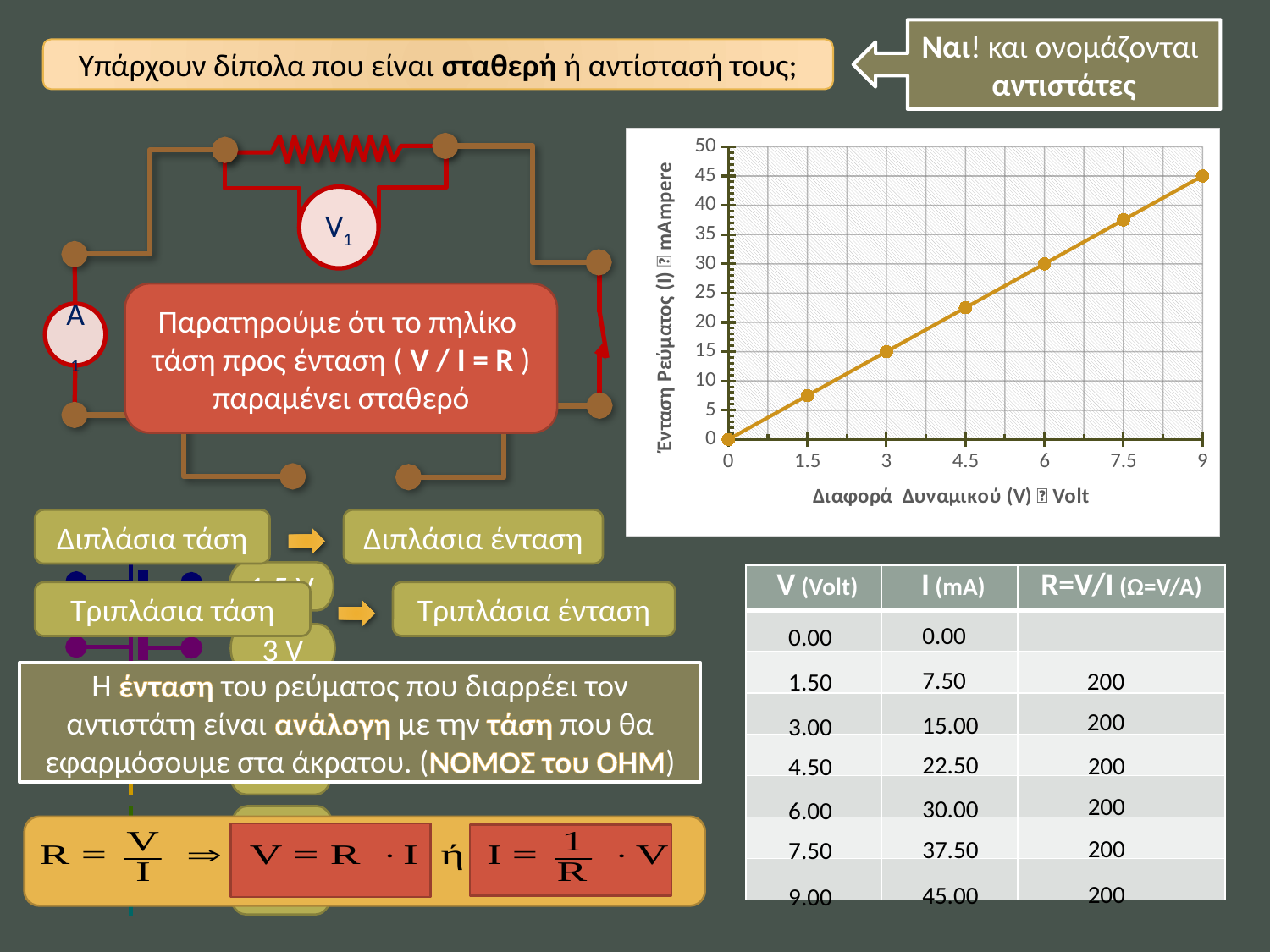
What is the current (I) in mAmpere when the potential difference is 6 Volt? 30 What is the current (I) in mAmpere when the potential difference is 3 Volt? 15 At which potential difference (V) is the plotted current lowest? 0 What is the current (I) in mAmpere when the potential difference is 9 Volt? 45 At which potential difference (V) is the plotted current highest? 9 What is the highest value shown on the chart's y axis? 50 Which has a larger current: the point at 6 Volt or the point at 3 Volt? 6 Volt How many data points are plotted on the chart? 7 What is the difference in current between the points at 9 Volt and 3 Volt? 30 Do the plotted current values rise or fall as the potential difference increases along the x axis? rise What kind of chart is shown on the slide? line chart Is the current at 4.5 Volt greater or less than 20 mAmpere? greater